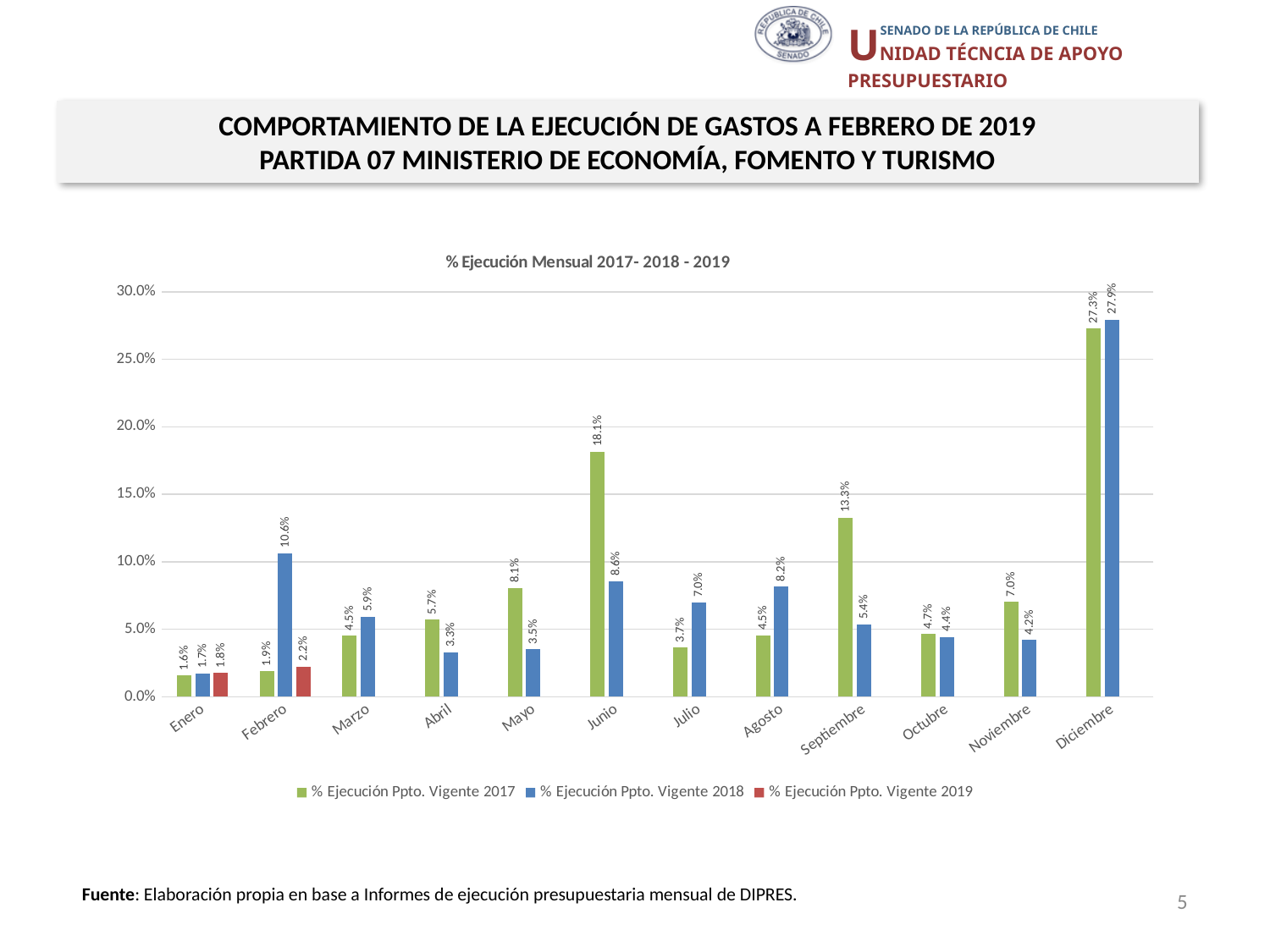
What is the value for % Ejecución Ppto. Vigente 2017 in Junio? 18.1% Which month has the lowest value for % Ejecución Ppto. Vigente 2018? Enero Is the value for % Ejecución Ppto. Vigente 2017 in Junio greater or less than 15.0%? greater What is the difference between the 2017 and 2018 values in Septiembre? 7.9% How many series does the legend list? 3 What is the title of the chart? % Ejecución Mensual 2017- 2018 - 2019 In Agosto, which is larger: the 2017 value or the 2018 value? 2018 What is the value for % Ejecución Ppto. Vigente 2019 in Febrero? 2.2% What kind of chart is shown on the slide? Bar chart What is the value for % Ejecución Ppto. Vigente 2018 in Febrero? 10.6% Which month has the highest value for % Ejecución Ppto. Vigente 2017? Diciembre How many months are shown on the x axis? 12